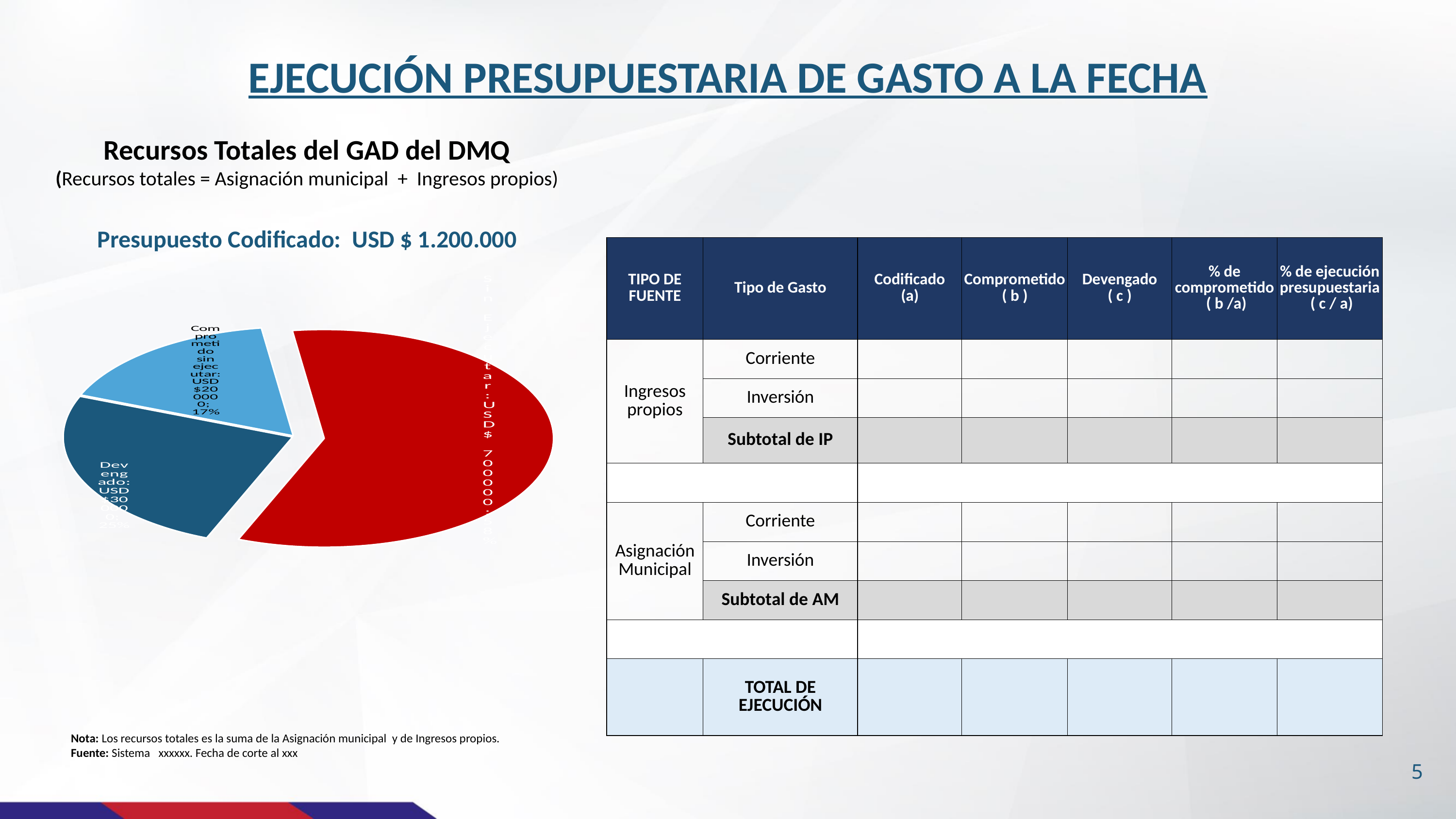
Which is larger in the pie chart, 'Devengado' or 'Comprometido sin ejecutar'? Devengado What value is shown for the 'Devengado' slice of the pie chart? USD $300000 What share of the pie does the 'Devengado' slice represent? 25% Which slice of the pie chart is the largest? Sin Ejecutar How many slices does the pie chart have? 3 What value is shown for the 'Comprometido sin ejecutar' slice of the pie chart? USD $200000 What 'Presupuesto Codificado' amount is stated above the pie chart? USD $ 1.200.000 What kind of chart is shown on the slide? pie chart What is the difference between the 'Devengado' value and the 'Comprometido sin ejecutar' value in the pie chart? USD $100000 What share of the pie does the 'Comprometido sin ejecutar' slice represent? 17% Which slice of the pie chart is the smallest? Comprometido sin ejecutar What colour is the largest slice of the pie chart? red